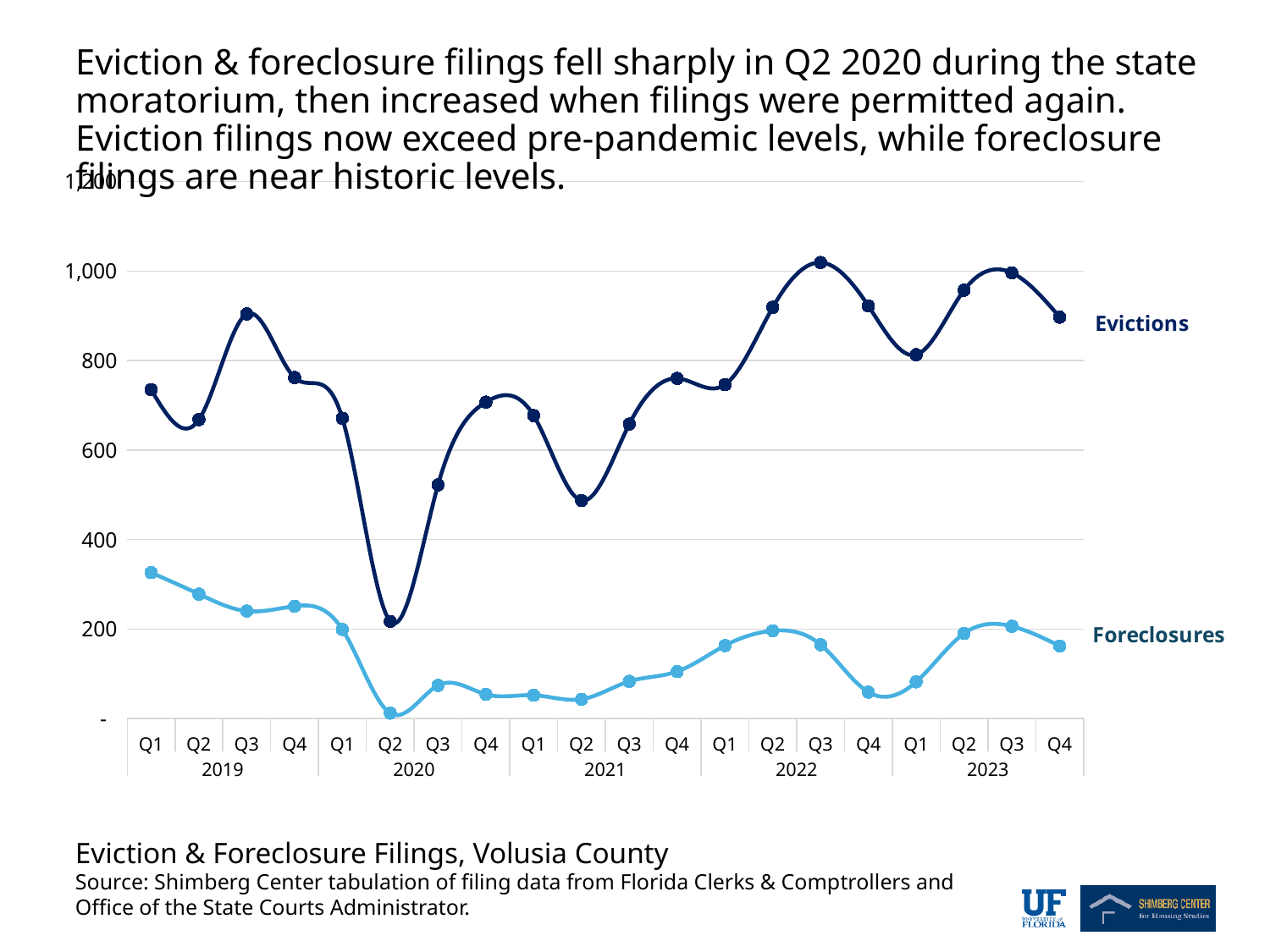
How many quarterly data points does each series have on the chart? 20 How many years are shown along the x axis of the chart? 5 What kind of chart is shown on the slide? Line chart Which is larger, Evictions in Q1 2019 or Evictions in Q1 2023? Q1 2023 How many data series are plotted on the chart? 2 Is the value for Evictions in Q2 2020 greater or less than 400? less Is the value for Foreclosures in Q4 2022 greater or less than 100? less Do Evictions rise or fall from Q1 2020 to Q2 2020? Fall In which quarter do Evictions reach their lowest value? Q2 2020 In which quarter do Foreclosures reach their lowest value? Q2 2020 Is the value for Evictions in Q3 2022 greater or less than 800? greater In which quarter do Foreclosures reach their highest value? Q1 2019